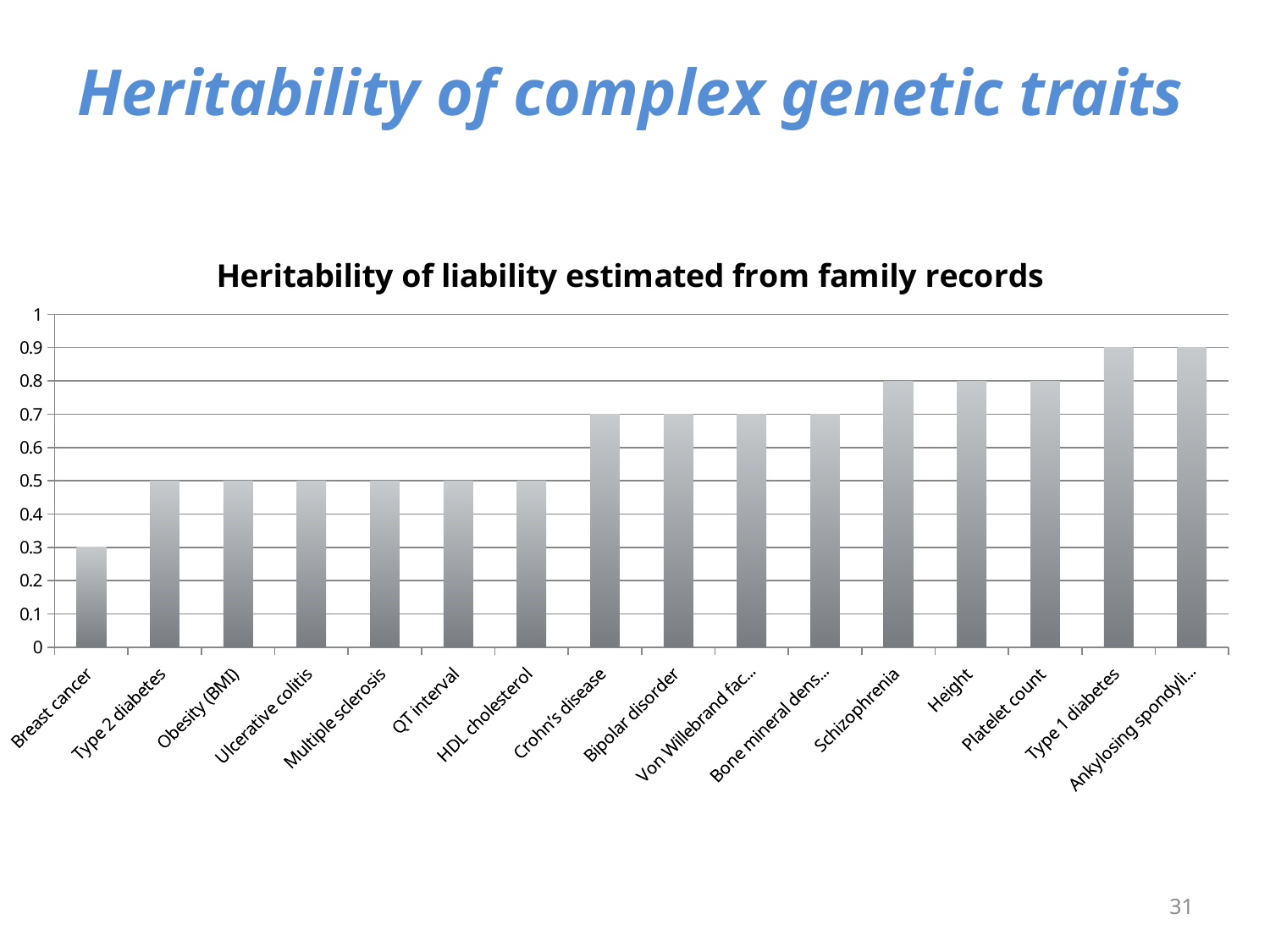
What is the heritability value for Type 1 diabetes? 0.9 Do the values generally rise or fall from left to right along the x axis? Rise How many traits are shown on the x axis? 16 Which trait has the lowest heritability value? Breast cancer Is the value for Bipolar disorder greater or less than 0.5? greater What is the heritability value for Breast cancer? 0.3 Which is larger, the value for Height or the value for QT interval? Height What is the difference between the values for Schizophrenia and Breast cancer? 0.5 What is the title of the chart? Heritability of liability estimated from family records What kind of chart is shown on the slide? Bar chart What is the heritability value for Schizophrenia? 0.8 What is the heritability value for Crohn's disease? 0.7